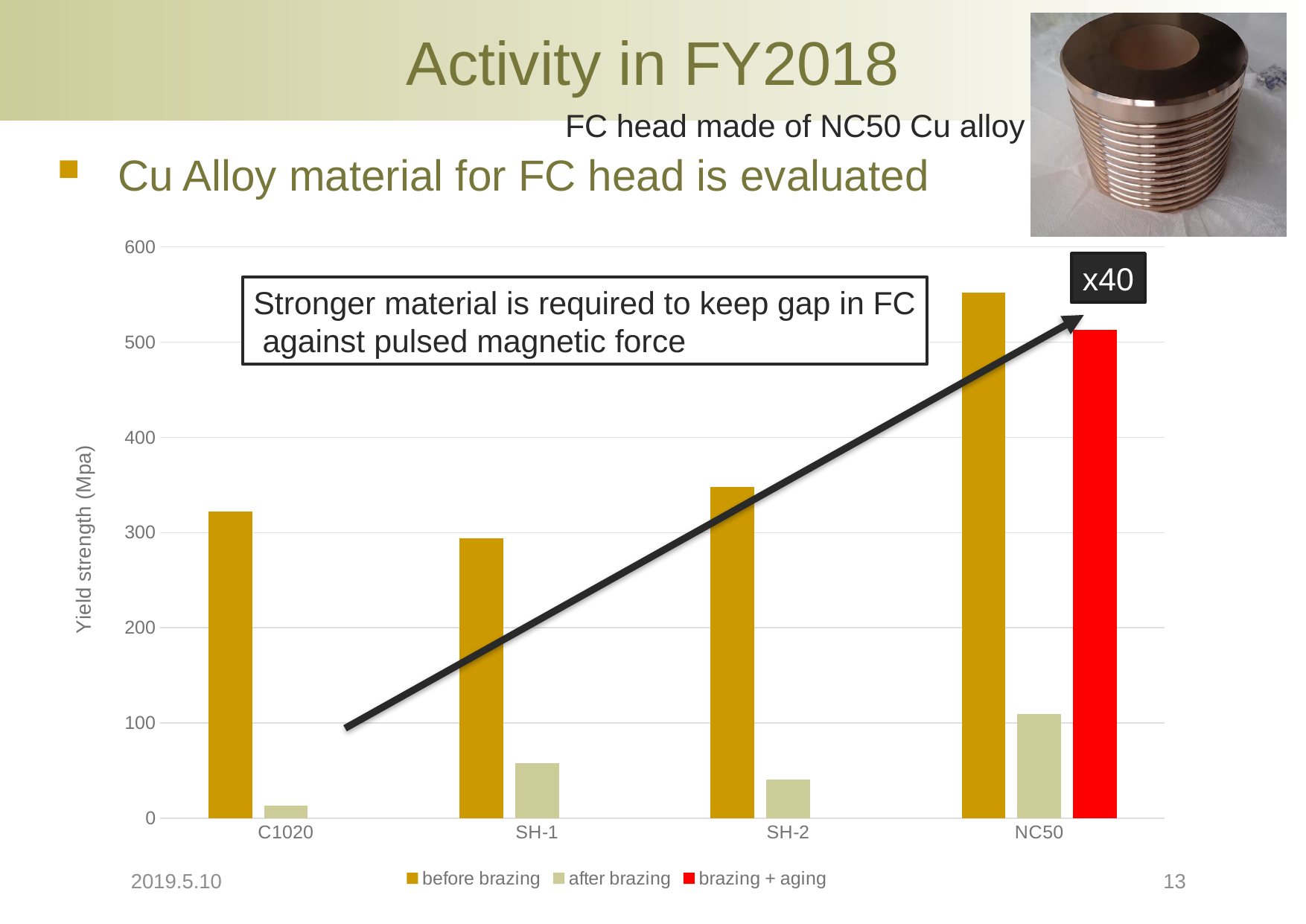
Which material has the highest 'before brazing' yield strength? NC50 Which material has the lowest 'after brazing' yield strength? C1020 Is the 'before brazing' value for SH-1 greater or less than 300? less What is the label of the y axis of the chart? Yield strength (Mpa) Which material has the lowest 'before brazing' yield strength? SH-1 Is the 'before brazing' value for NC50 greater or less than 500? greater Which is larger, the 'before brazing' value for SH-2 or the 'before brazing' value for C1020? SH-2 Which material is the only one with a 'brazing + aging' bar? NC50 How many material categories are shown on the x axis of the chart? 4 Is the 'after brazing' value for NC50 greater or less than 100? greater What kind of chart is shown on the slide? bar chart How many series does the chart legend list? 3